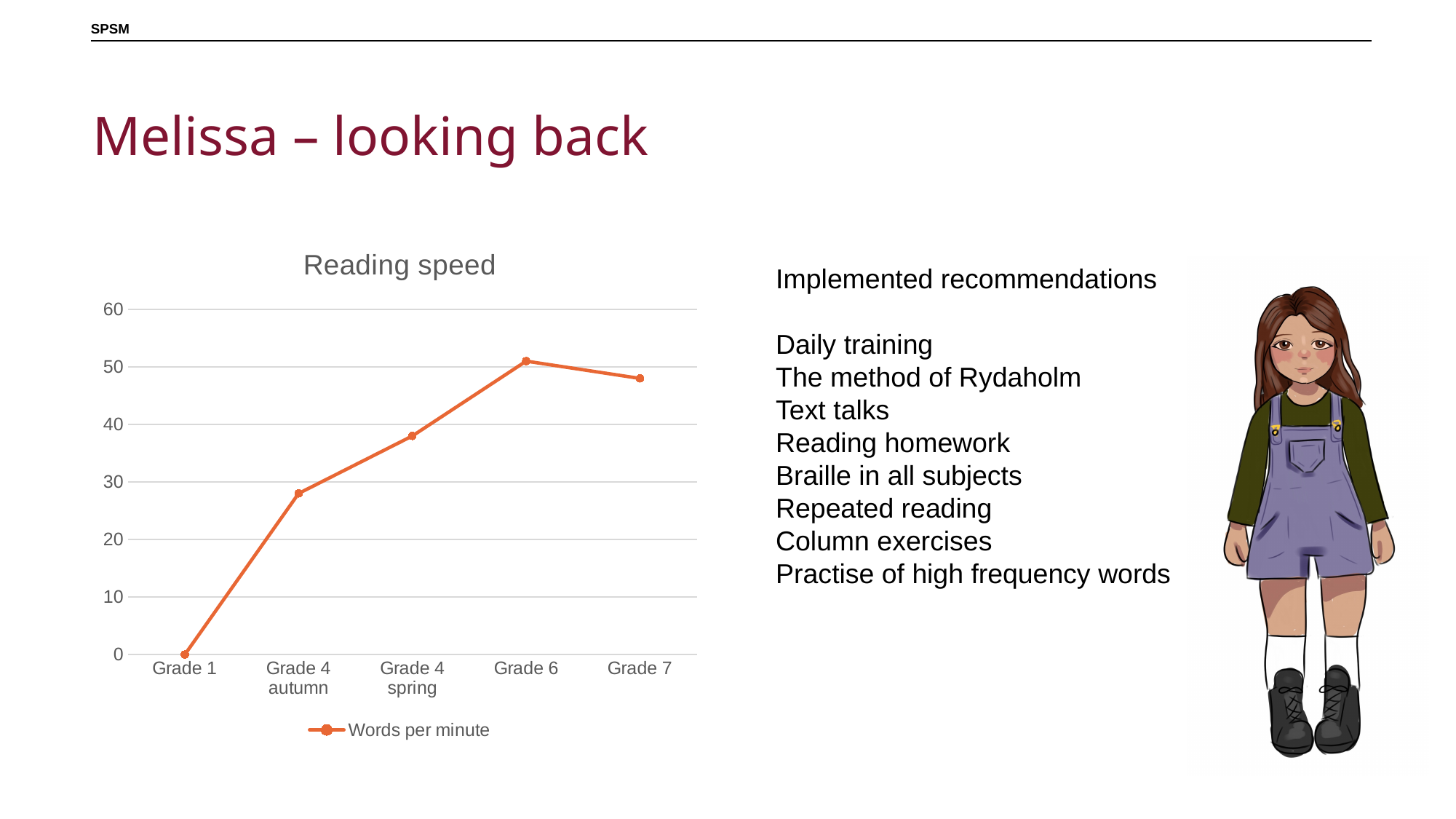
What is the value for Grade 1? 0 How many series does the legend list? 1 Does the reading speed rise or fall from Grade 1 to Grade 6? rise Which is larger, the value for Grade 6 or the value for Grade 7? Grade 6 What kind of chart is shown on the slide? Line chart Is the value for Grade 4 spring greater or less than 30? greater Which category has the highest reading speed? Grade 6 Which category has the lowest reading speed? Grade 1 What is the title of the chart? Reading speed Is the value for Grade 4 autumn greater or less than 20? greater What series does the chart's legend list? Words per minute How many data points are plotted on the chart? 5